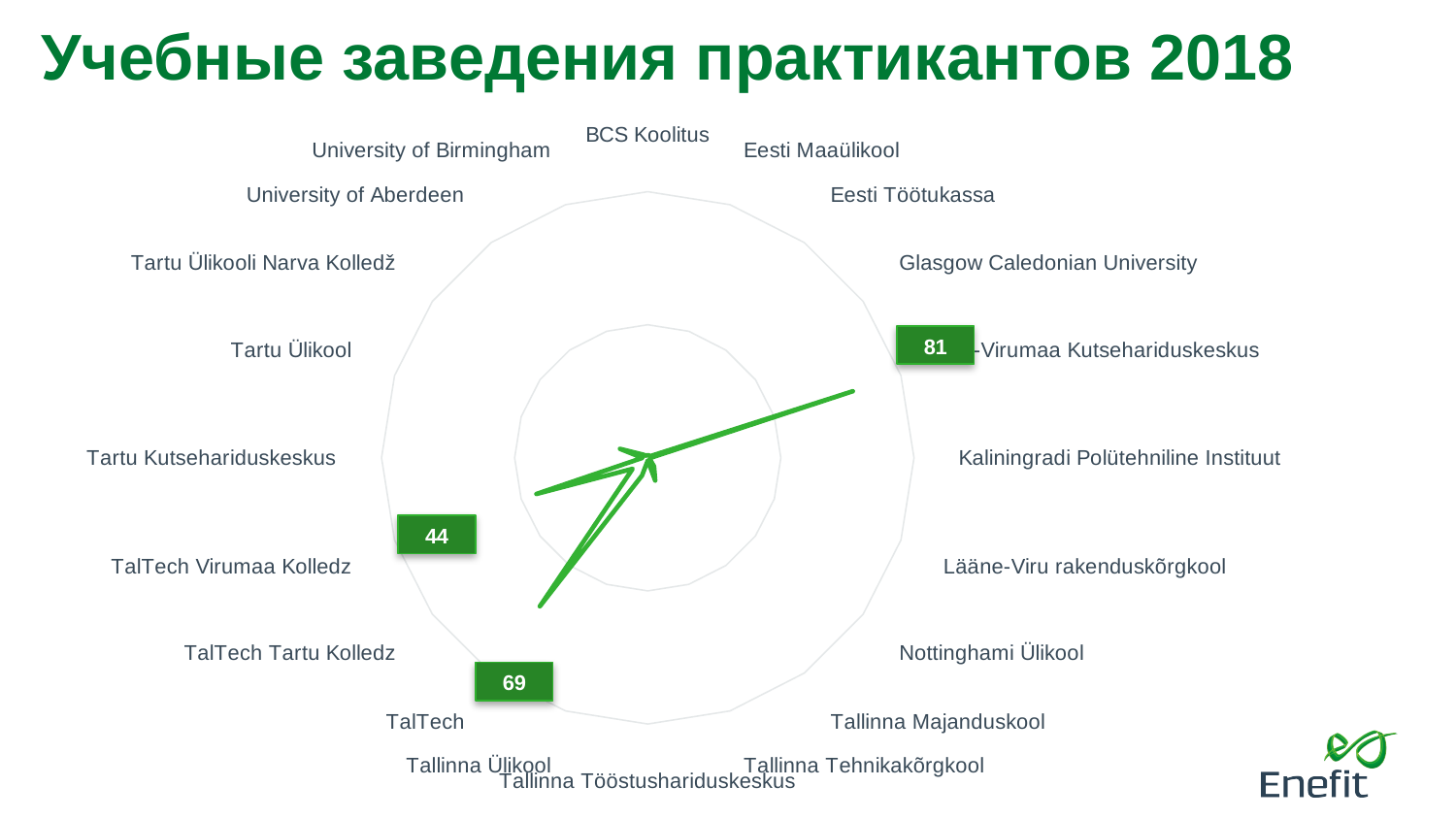
What is the highest value labelled on the chart? 81 Which is larger, the value for TalTech or the value for TalTech Virumaa Kolledz? TalTech Of the three labelled values, which category has the lowest value? TalTech Virumaa Kolledz What colour is the plotted data line on the chart? Green What is the title of the slide? Учебные заведения практикантов 2018 What kind of chart is shown on the slide? Radar chart What is the difference between the highest labelled value and the value for TalTech? 12 What is the difference between the values for TalTech and TalTech Virumaa Kolledz? 25 What is the value for TalTech Virumaa Kolledz? 44 How many categories (institutions) are listed around the chart? 20 What is the value for TalTech? 69